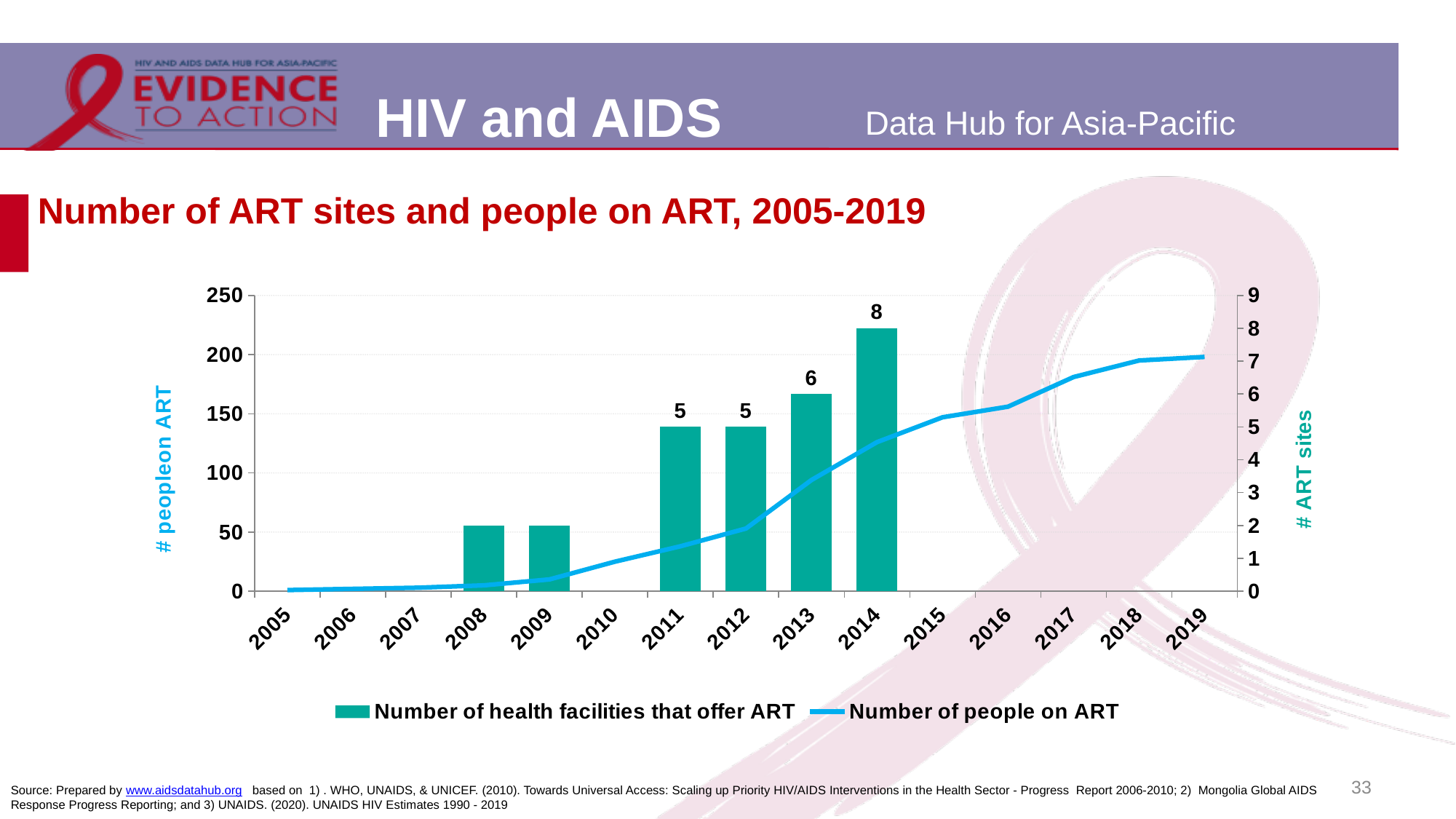
What is the number of health facilities that offer ART in 2011? 5 What kind of chart is shown on the slide? Combination bar and line chart What is the difference between the number of health facilities that offer ART in 2014 and in 2013? 2 How many series does the legend list? 2 Does the number of people on ART rise or fall from 2005 to 2019? Rise How many years are shown on the x axis of the chart? 15 Is the number of people on ART in 2010 greater or less than 50? less Is the number of people on ART in 2019 greater or less than 150? greater What is the number of health facilities that offer ART in 2014? 8 Which year has more health facilities that offer ART, 2012 or 2013? 2013 In which year is the number of health facilities that offer ART highest? 2014 What is the number of health facilities that offer ART in 2013? 6